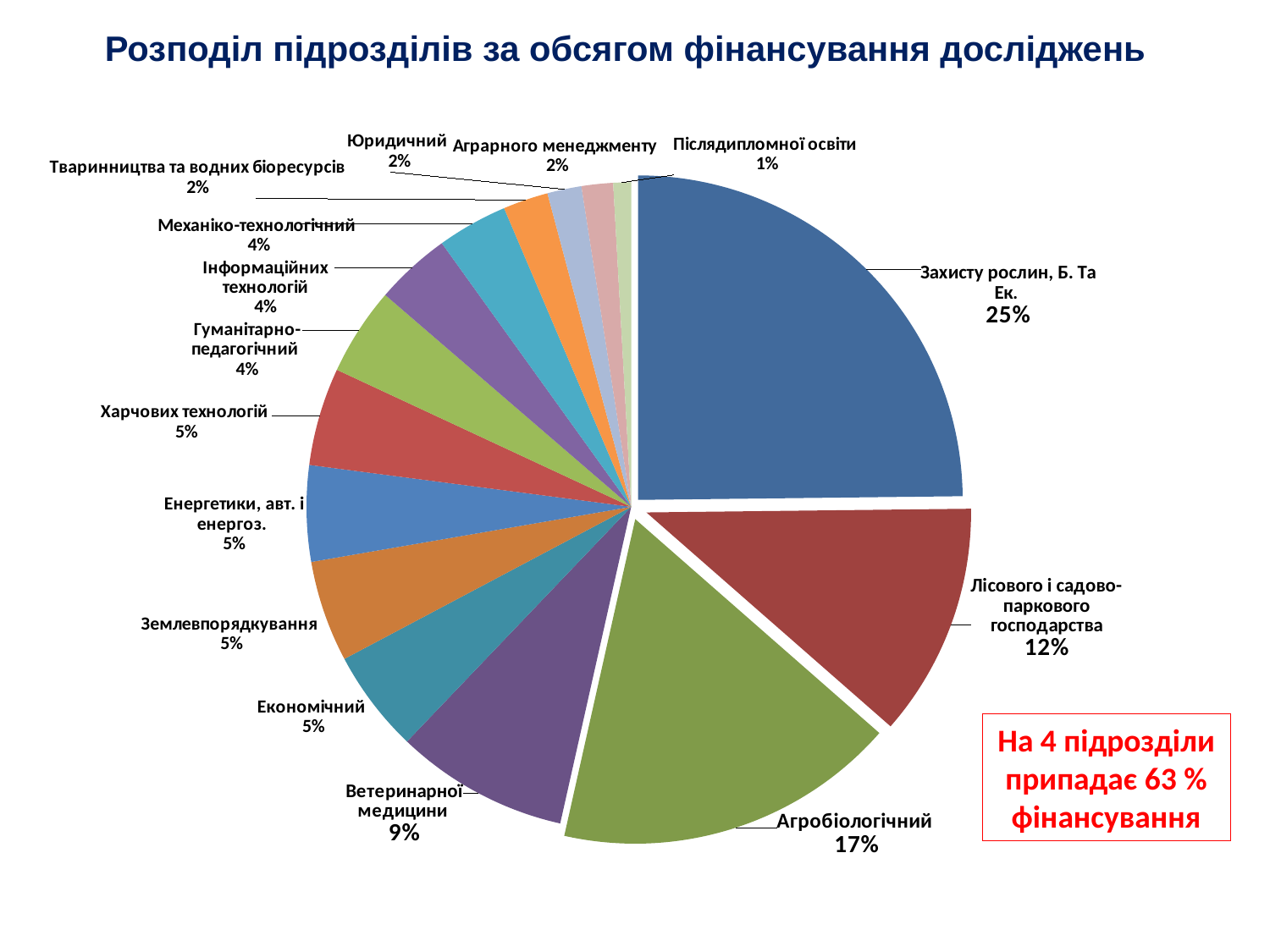
What percentage is shown for Механіко-технологічний? 4% How many slices does the pie chart have? 15 What share of research funding goes to the Агробіологічний unit? 17% According to the red text box, what share of funding falls on 4 units? 63 % What kind of chart is shown on the slide? pie chart Which has a larger share: Ветеринарної медицини or Лісового і садово-паркового господарства? Лісового і садово-паркового господарства What percentage is shown for Ветеринарної медицини? 9% What percentage is shown for Лісового і садово-паркового господарства? 12% What is the difference in percentage points between Захисту рослин, Б. Та Ек. and Агробіологічний? 8 Which unit has the largest share of research funding? Захисту рослин, Б. Та Ек. What is the title of the chart? Розподіл підрозділів за обсягом фінансування досліджень Which unit has the smallest share of research funding? Післядипломної освіти